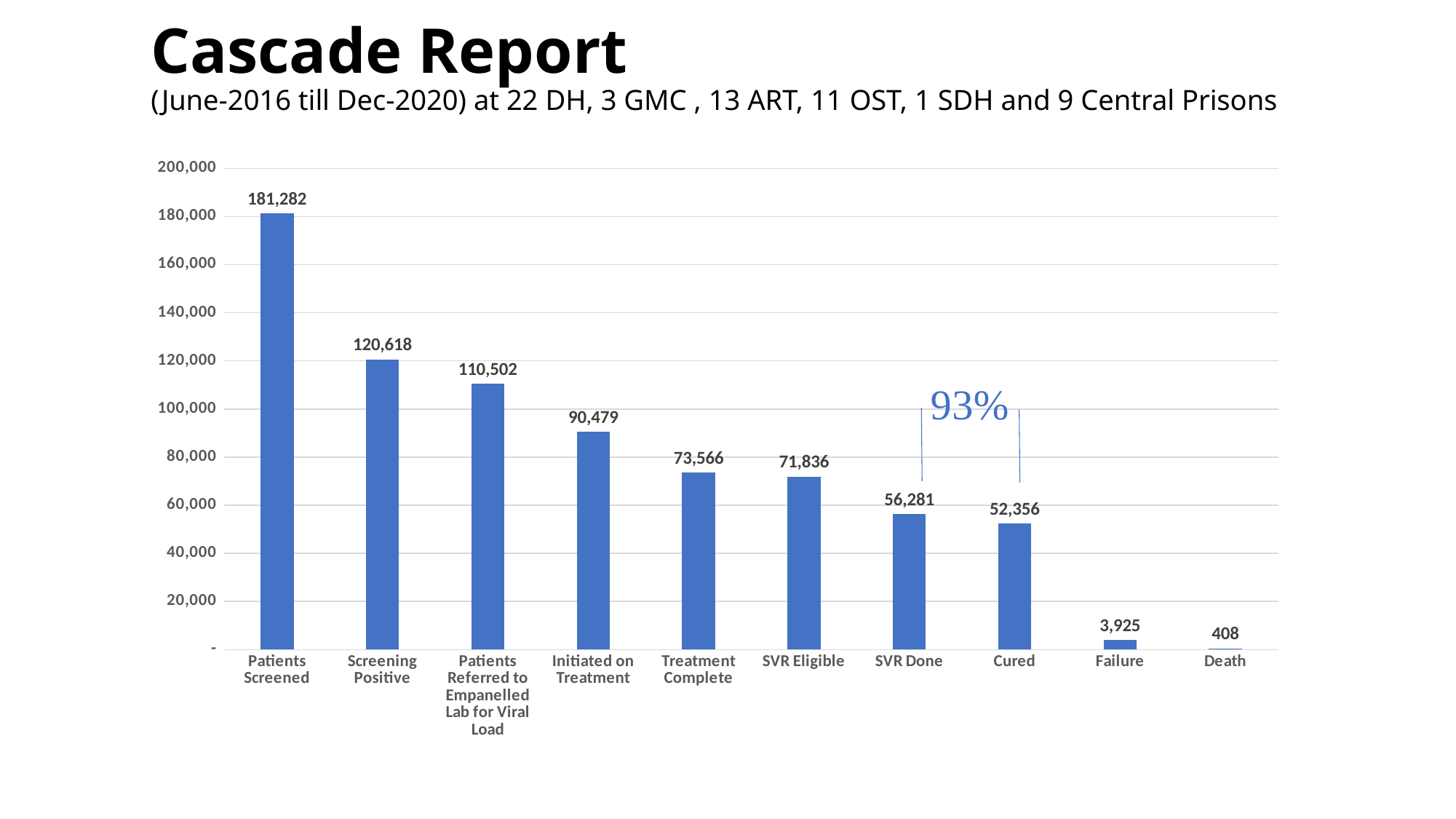
Which category has the highest value? Patients Screened What is the value for Patients Screened? 181,282 What is the value for Death? 408 Which is larger, Treatment Complete or SVR Eligible? Treatment Complete Which category has the lowest value? Death What is the difference between Screening Positive and Patients Referred to Empanelled Lab for Viral Load? 10,116 What percentage is annotated between SVR Done and Cured? 93% How many categories are shown on the x axis? 10 What is the value for SVR Done? 56,281 What is the difference between SVR Done and Cured? 3,925 Is the value for Initiated on Treatment greater or less than 100,000? less What kind of chart is shown on the slide? bar chart